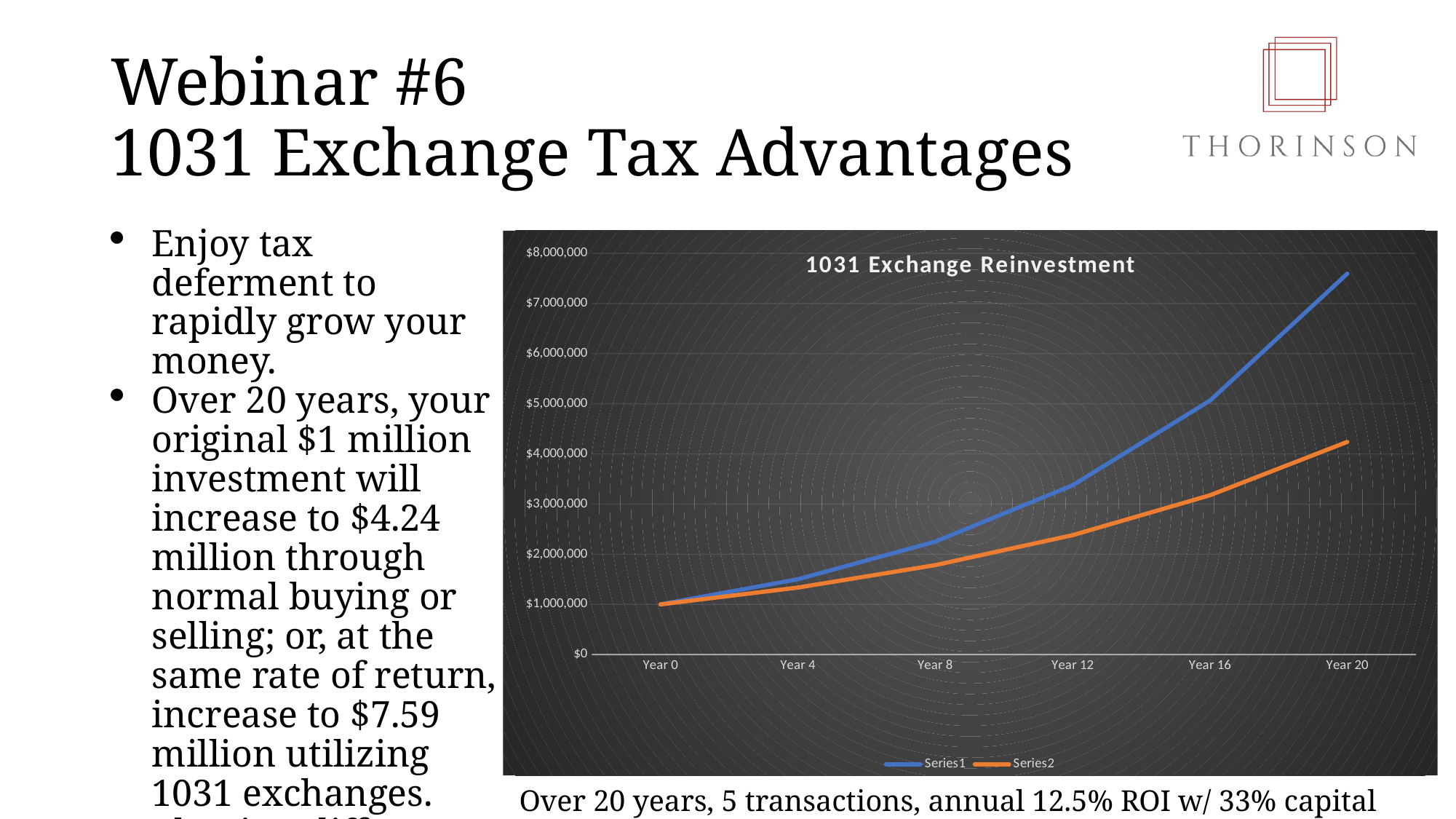
How many year labels are shown on the x axis of the chart? 6 At Year 20, which series has the larger value, Series1 or Series2? Series1 What is the title of the chart? 1031 Exchange Reinvestment What is the value for Series1 at Year 0? $1,000,000 Is the value for Series1 at Year 20 greater or less than $7,000,000? greater At which year does Series1 reach its highest value? Year 20 Is the value for Series1 at Year 16 greater or less than $4,000,000? greater Do the values for Series1 rise or fall from Year 0 to Year 20? rise Is the value for Series2 at Year 20 greater or less than $5,000,000? less How many series does the legend of the chart list? 2 What kind of chart is shown on the slide? line chart